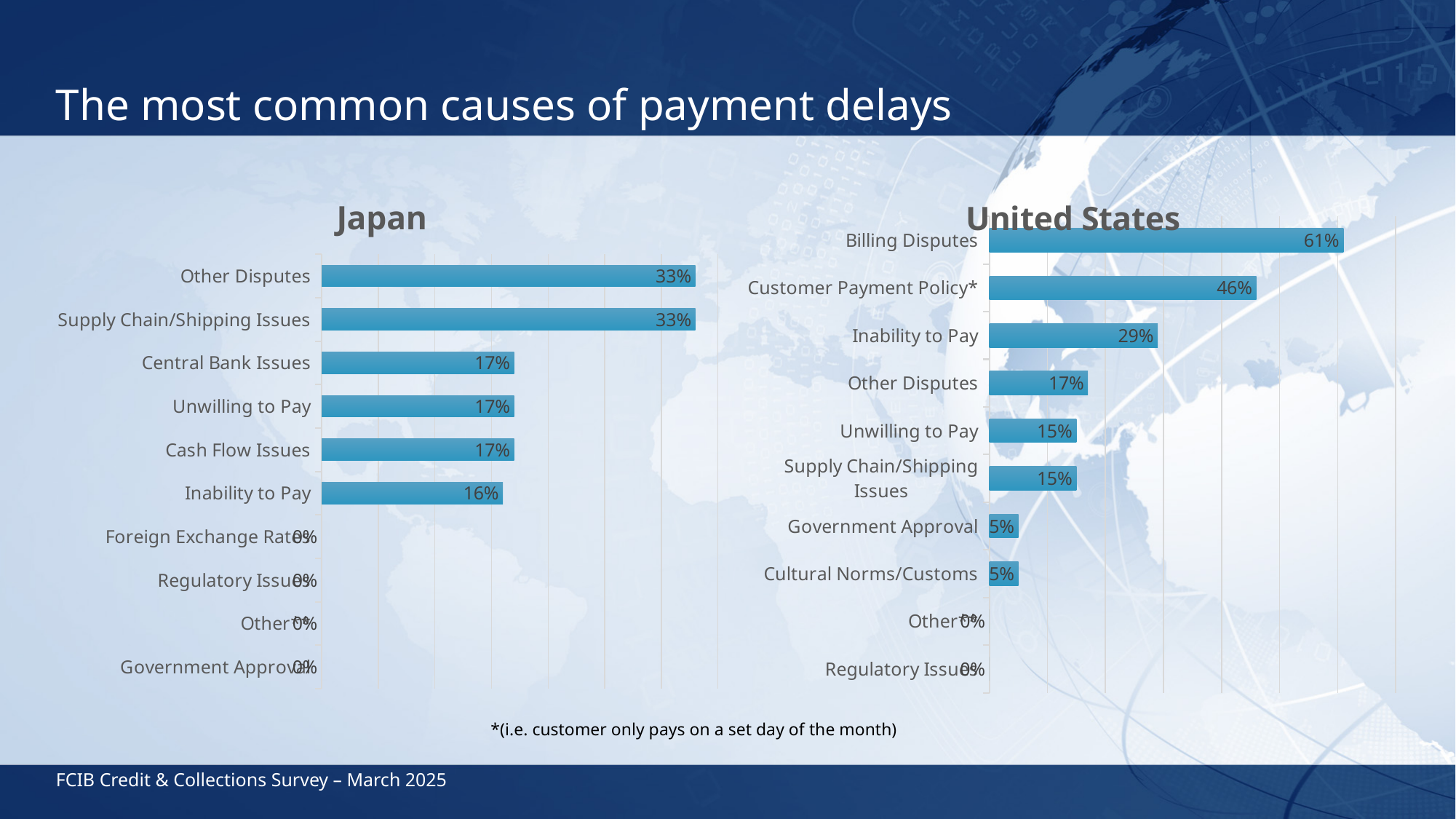
In the Japan chart, what is the value for Central Bank Issues? 17% Which is larger: Inability to Pay in the United States chart or Inability to Pay in the Japan chart? United States In the Japan chart, what is the value for Inability to Pay? 16% In the United States chart, what is the difference between Billing Disputes and Customer Payment Policy*? 15% How many categories does the Japan chart show? 10 In the United States chart, what is the value for Cultural Norms/Customs? 5% In the United States chart, which category has the highest value? Billing Disputes In the Japan chart, what is the difference between Other Disputes and Inability to Pay? 17% What kind of chart is the United States chart? Bar chart In the United States chart, which is larger: Other Disputes or Government Approval? Other Disputes In the United States chart, what is the value for Billing Disputes? 61% In the United States chart, what is the value for Customer Payment Policy*? 46%